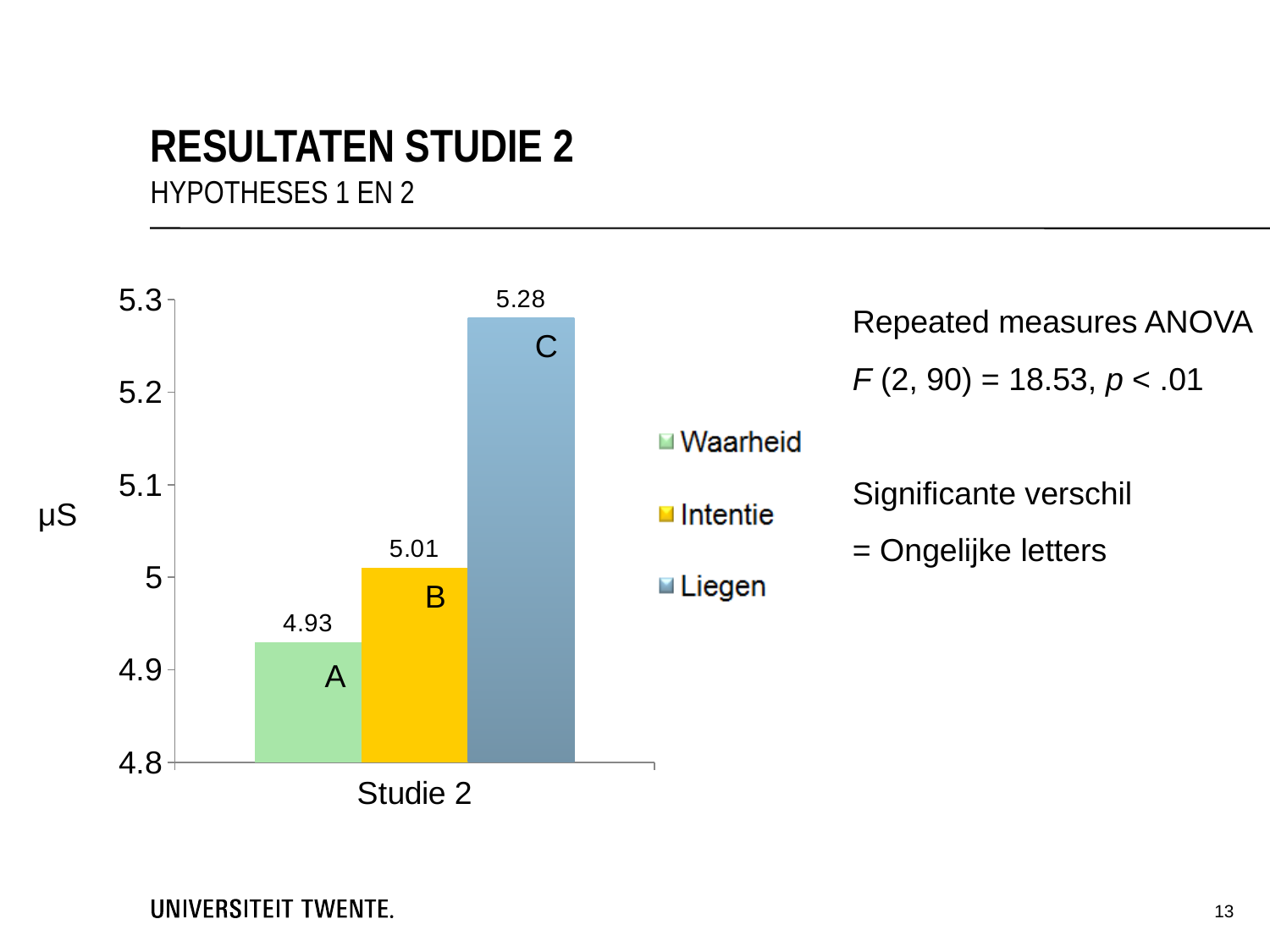
What kind of chart is shown on the slide? bar chart Is the value for Waarheid greater or less than 5? less What is the difference between the values for Intentie and Waarheid? 0.08 What is the difference between the values for Liegen and Waarheid? 0.35 Which series has the highest value? Liegen What unit is shown on the y axis of the chart? µS What is the value for Liegen in Studie 2? 5.28 What is the value for Intentie in Studie 2? 5.01 How many series does the legend list? 3 Which is larger, the value for Intentie or the value for Liegen? Liegen What is the value for Waarheid in Studie 2? 4.93 Which series has the lowest value? Waarheid